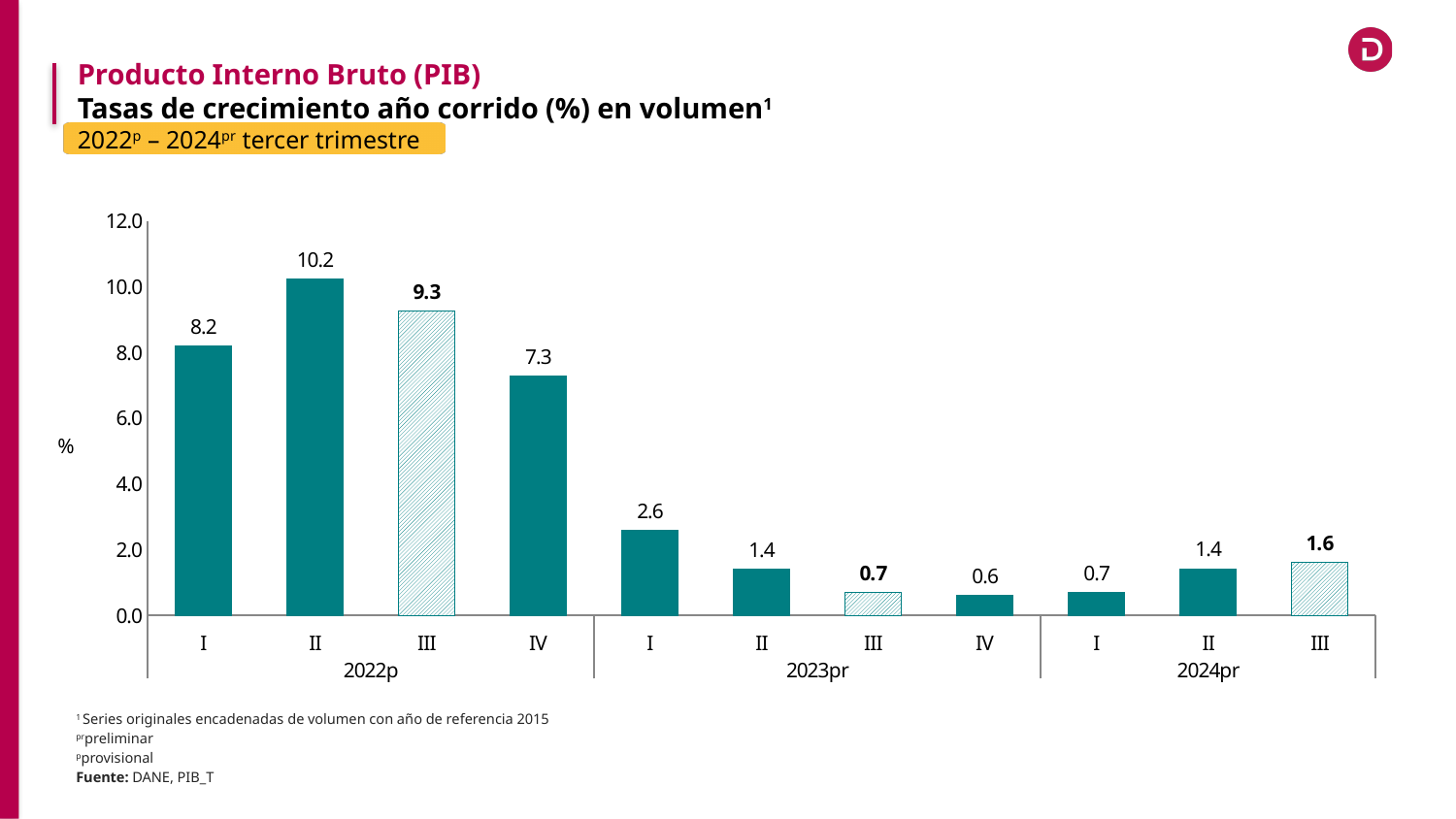
What is the year-to-date growth rate for quarter III of 2024pr? 1.6 What is the value shown for quarter IV of 2023pr? 0.6 Which is larger, the value for quarter I of 2022p or quarter IV of 2022p? I 2022p What kind of chart is shown on the slide? bar chart What is the difference between the values for quarter III of 2022p and quarter III of 2023pr? 8.6 Which quarter has the lowest growth rate on the chart? IV 2023pr Which quarter has the highest growth rate on the chart? II 2022p What is the source cited for the chart? DANE, PIB_T How many bars are plotted on the chart? 11 Do the values rise or fall across the four quarters of 2023pr? fall Is the value for quarter I of 2023pr greater or less than 2.0? greater What is the value shown for quarter II of 2022p? 10.2